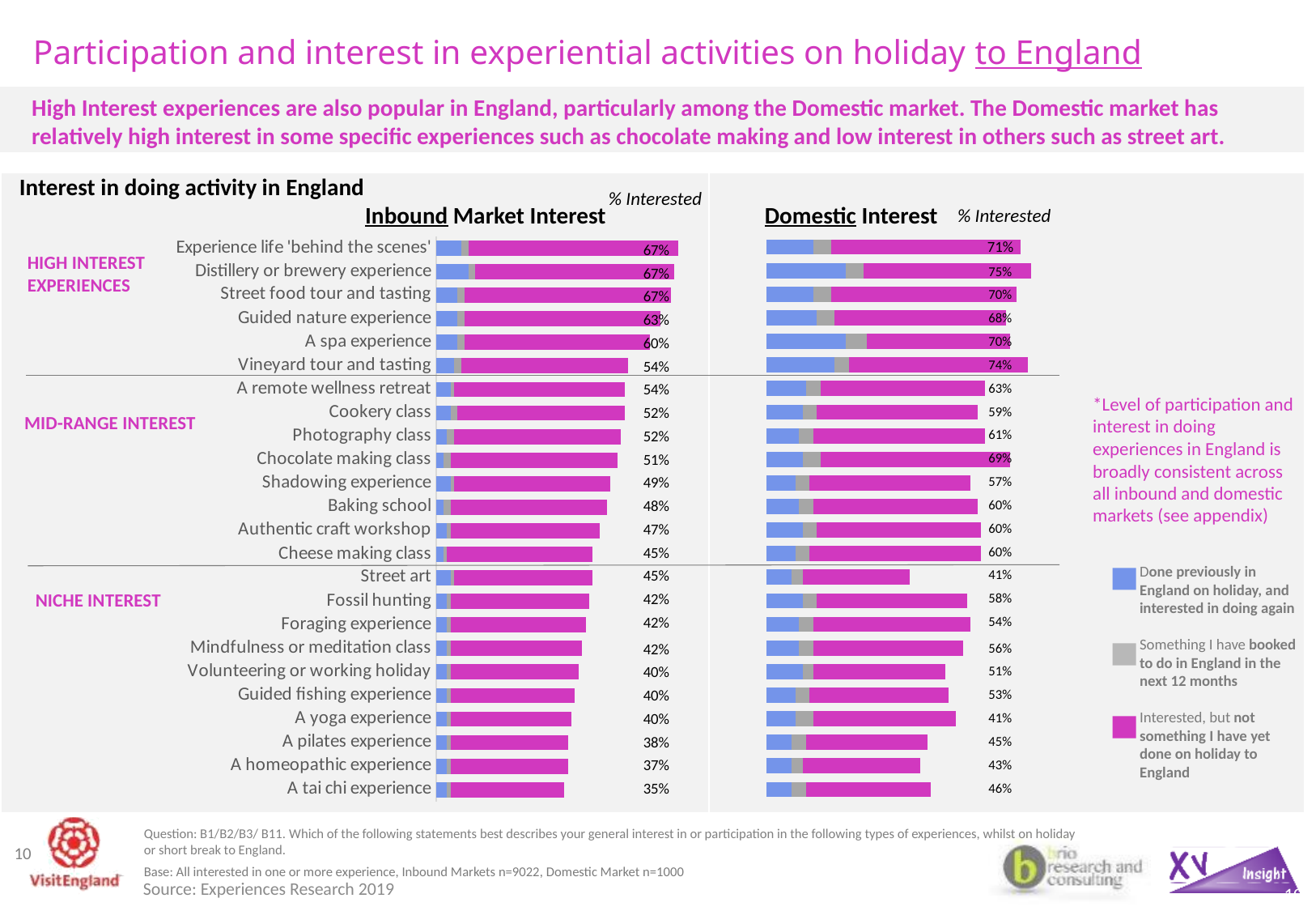
For Street art, which is larger: the Inbound Market Interest value or the Domestic Interest value? Inbound Market Interest In the Domestic Interest chart, what is the % Interested value for Chocolate making class? 69% What type of chart is the Domestic Interest chart? Stacked bar chart What is the difference between the Domestic Interest and Inbound Market Interest % Interested values for Chocolate making class? 18 percentage points Which colour in the legend represents 'Interested, but not something I have yet done on holiday to England'? Pink How many series does the legend list for the charts? 3 How many activities are listed in the Inbound Market Interest chart? 24 In the Inbound Market Interest chart, which activity has the lowest % Interested value? A tai chi experience In the Domestic Interest chart, which activity has the highest % Interested value? Distillery or brewery experience In the Inbound Market Interest chart, what is the % Interested value for Vineyard tour and tasting? 54% In the Inbound Market Interest chart, what is the % Interested value for A spa experience? 60% In the Domestic Interest chart, what is the % Interested value for Street art? 41%